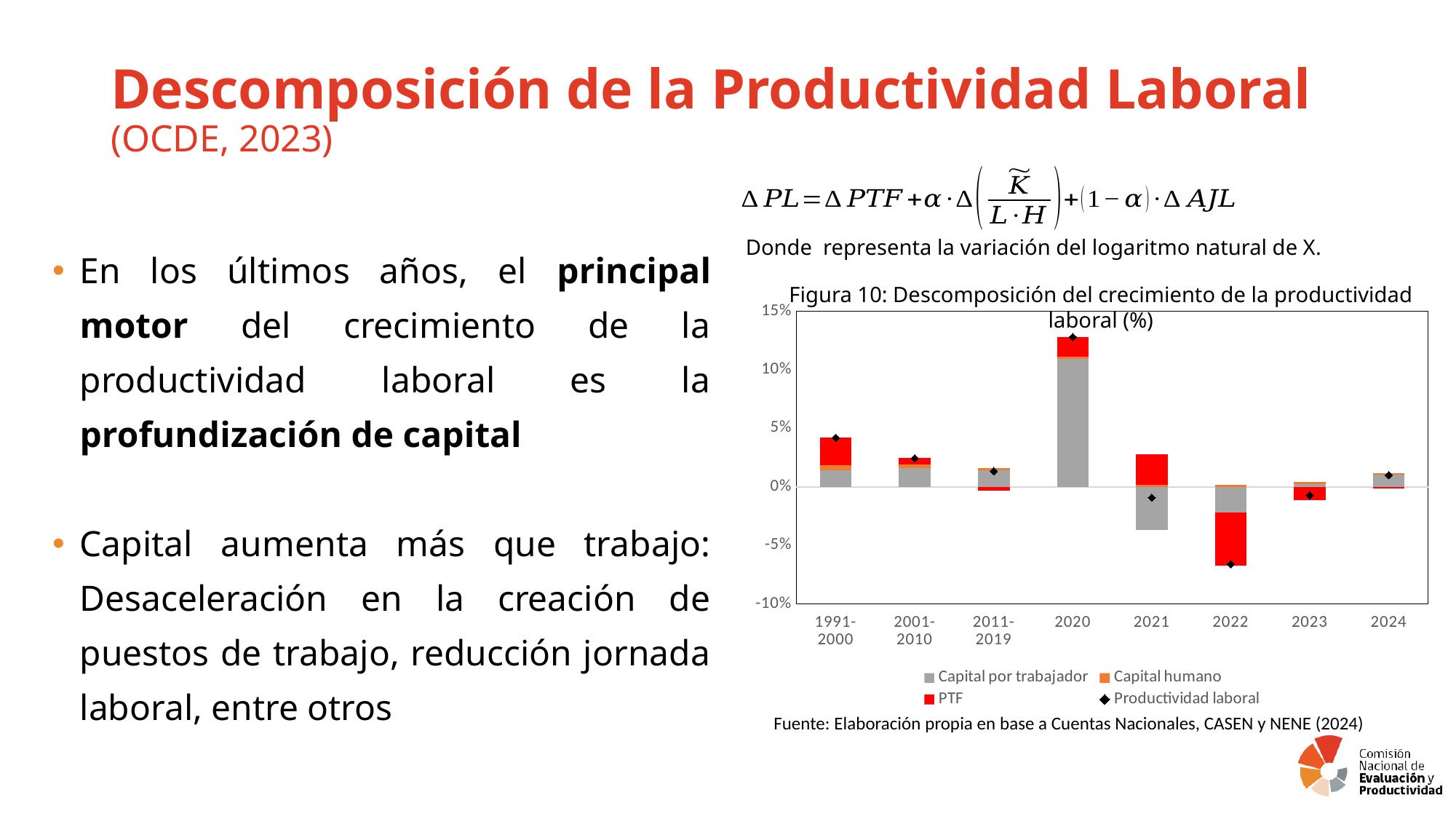
How many series does the legend of Figura 10 list? 4 What kind of chart is Figura 10? Stacked bar chart with markers Is the Productividad laboral value for 2022 greater or less than -5%? less In which period is the Productividad laboral marker highest in Figura 10? 2020 In which period is the Productividad laboral marker lowest in Figura 10? 2022 How many periods are shown on the x axis of Figura 10? 8 What is the title of the chart on the slide? Figura 10: Descomposición del crecimiento de la productividad laboral (%) Is the Productividad laboral value for 1991-2000 greater or less than 5%? less Which period has the larger Productividad laboral value, 1991-2000 or 2001-2010? 1991-2000 Is the Capital por trabajador contribution in 2020 greater or less than 5%? greater Which colour represents PTF in Figura 10? Red